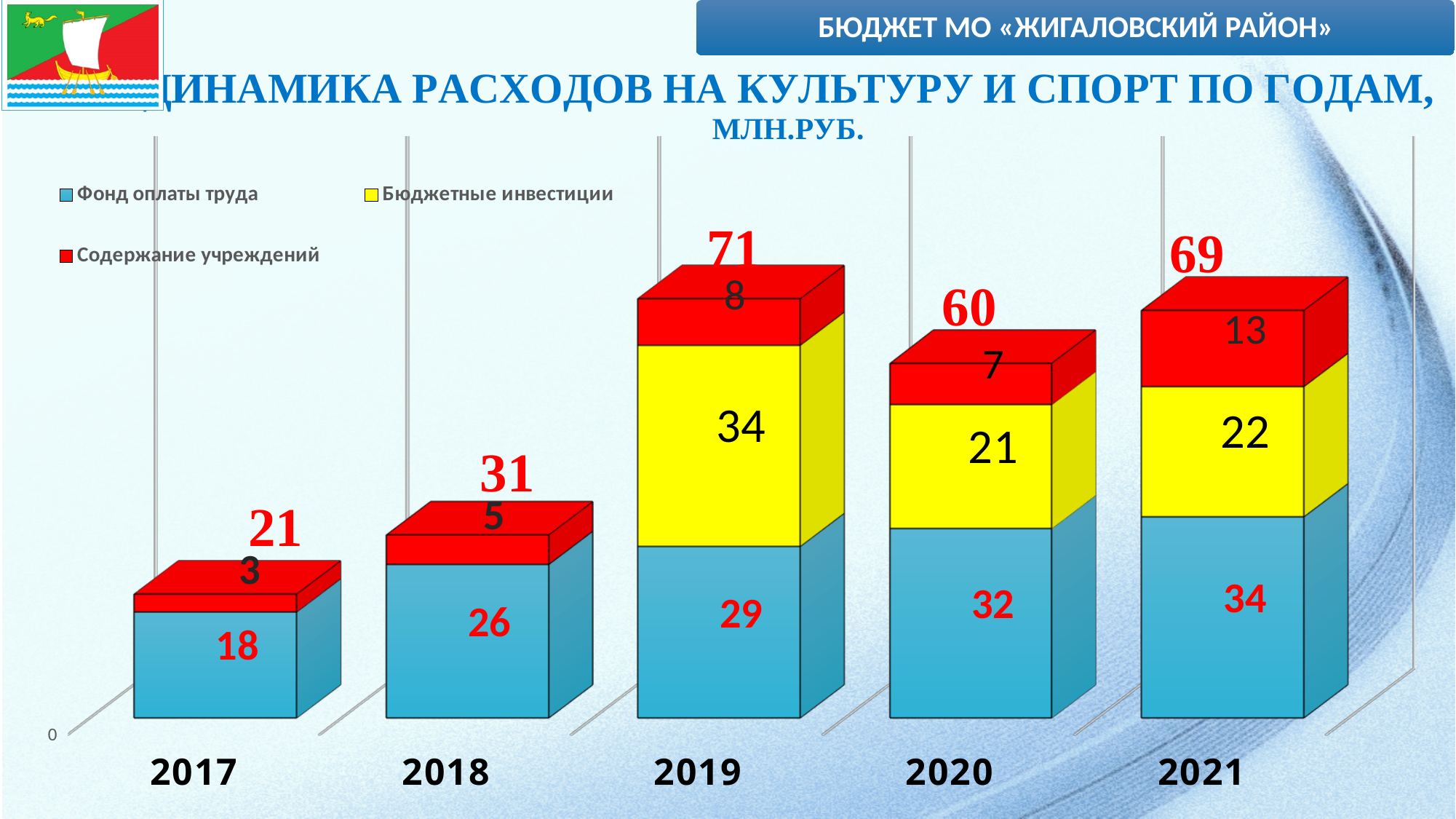
What is the value of Содержание учреждений for 2021? 13 What is the value of Бюджетные инвестиции for 2020? 21 Which is larger: Фонд оплаты труда in 2020 or in 2021? 2021 Which colour represents Бюджетные инвестиции in the chart? Yellow How many series does the legend list? 3 Which year has the lowest total expenditure? 2017 What kind of chart is shown on the slide? Stacked bar chart How many years are shown on the x axis? 5 What is the difference between the Бюджетные инвестиции values for 2019 and 2021? 12 What is the total shown above the stacked bar for 2018? 31 What is the value of Фонд оплаты труда for 2019? 29 Which year has the highest total expenditure? 2019